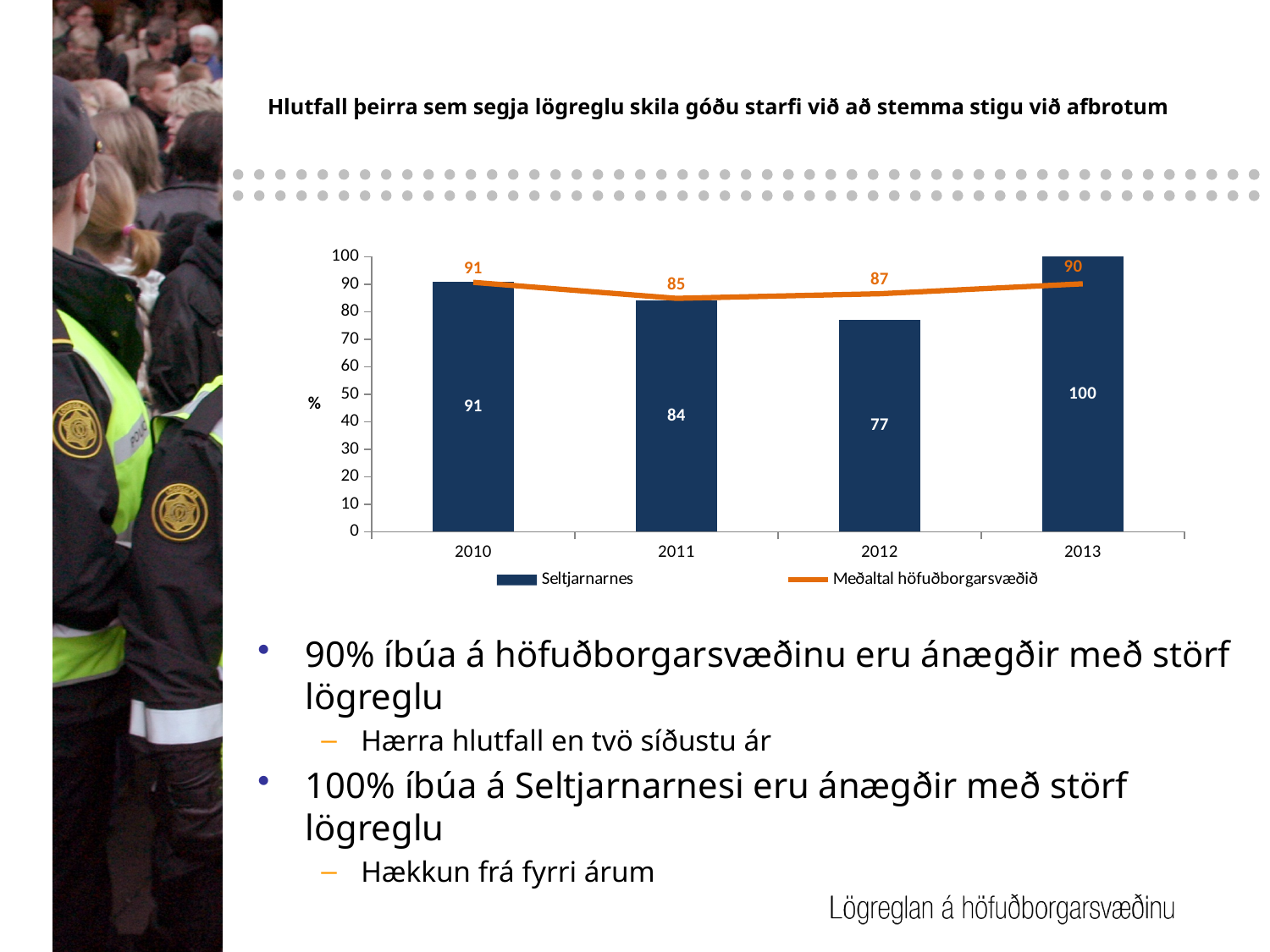
What kind of chart is shown on the slide? Combined bar and line chart How many series does the legend list? 2 Does the Meðaltal höfuðborgarsvæðið line rise or fall from 2011 to 2013? Rise Which is larger in 2012: Seltjarnarnes or Meðaltal höfuðborgarsvæðið? Meðaltal höfuðborgarsvæðið What is the value for Seltjarnarnes in 2013? 100 What is the value of Meðaltal höfuðborgarsvæðið in 2011? 85 In which year is the Seltjarnarnes value lowest? 2012 How many years are shown on the x axis? 4 What is the value for Seltjarnarnes in 2012? 77 What is the difference between the Seltjarnarnes value in 2013 and in 2012? 23 What colour are the Seltjarnarnes bars? Dark blue In which year is the Seltjarnarnes value highest? 2013